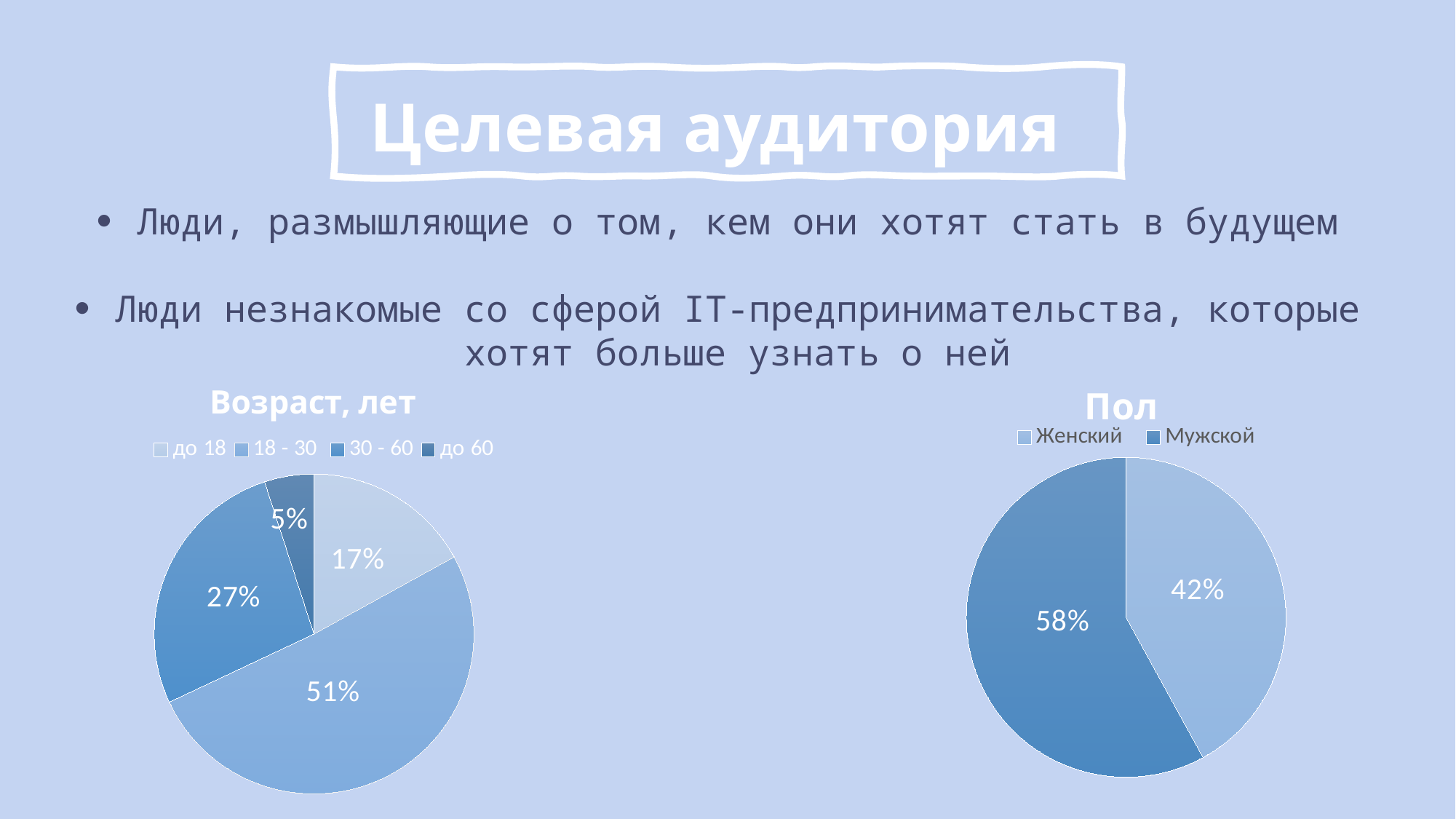
In the 'Возраст, лет' chart, what is the difference between the '18 - 30' and '30 - 60' shares? 24% In the 'Пол' chart, what share is labelled for 'Мужской'? 58% In the 'Возраст, лет' chart, which category has the largest slice? 18 - 30 What type of chart is the 'Пол' chart? Pie chart In the 'Возраст, лет' chart, what share is labelled for the 'до 18' slice? 17% In the 'Пол' chart, what share is labelled for 'Женский'? 42% In the 'Пол' chart, what is the difference between the 'Мужской' and 'Женский' shares? 16% In the 'Возраст, лет' chart, which category has the smallest slice? до 60 In the 'Возраст, лет' chart, what share is labelled for the '30 - 60' slice? 27% In the 'Возраст, лет' chart, what share is labelled for the '18 - 30' slice? 51% In the 'Возраст, лет' chart, how many categories does the legend list? 4 In the 'Пол' chart, which category is larger, 'Женский' or 'Мужской'? Мужской